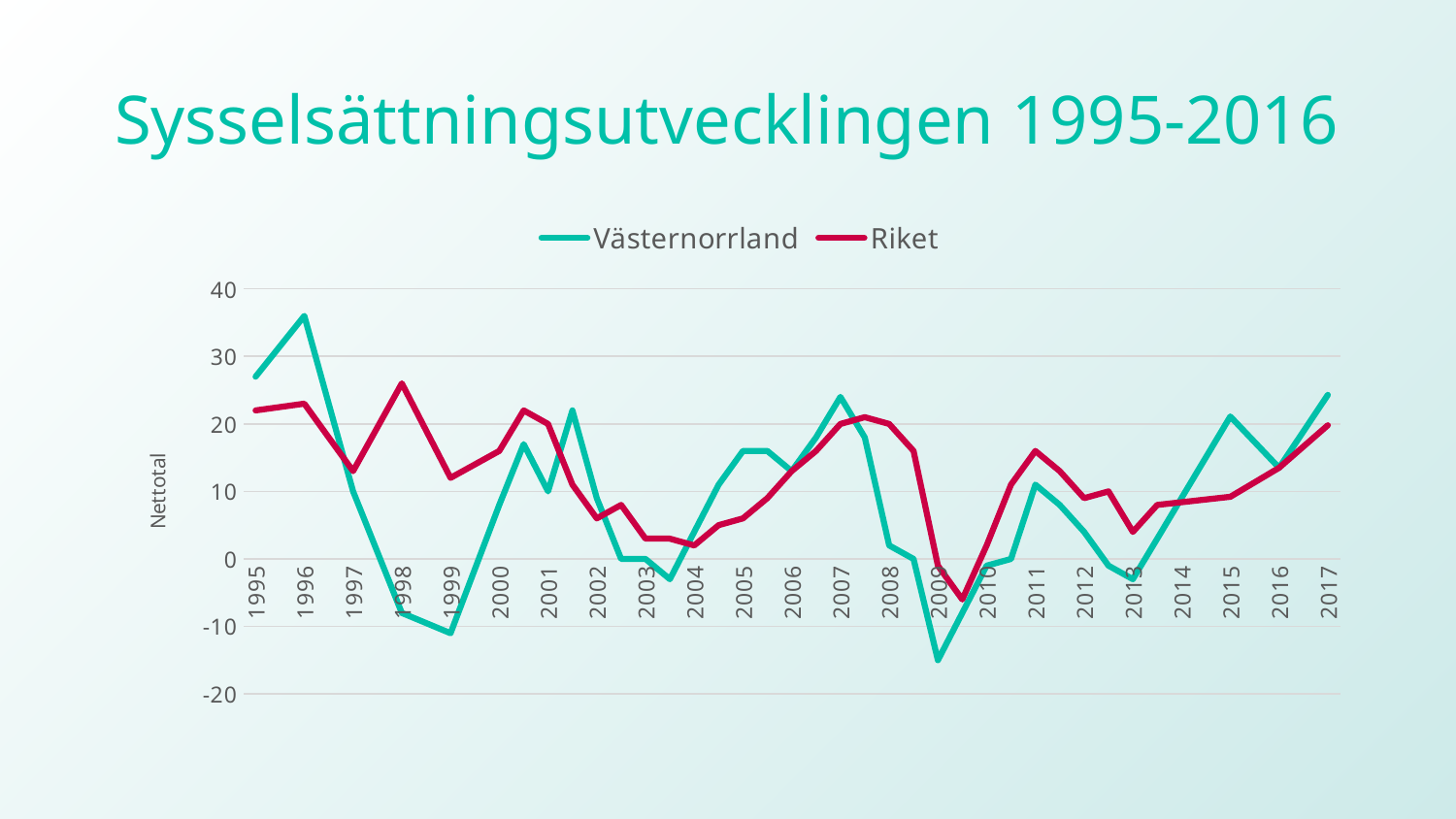
Which series has the higher value in 2015, Västernorrland or Riket? Västernorrland How many series does the legend list? 2 How many years are plotted along the x axis? 23 In which year does the Västernorrland series reach its lowest value? 2009 In which year does the Riket series reach its lowest value? 2009 In which year does the Riket series reach its highest value? 1998 Is the value for Västernorrland in 1996 greater or less than 30? greater Is the value for Västernorrland in 2009 greater or less than -10? less What kind of chart is shown on the slide? line chart In which year does the Västernorrland series reach its highest value? 1996 Is the value for Riket in 2009 greater or less than 0? less Which series has the higher value in 1998, Västernorrland or Riket? Riket